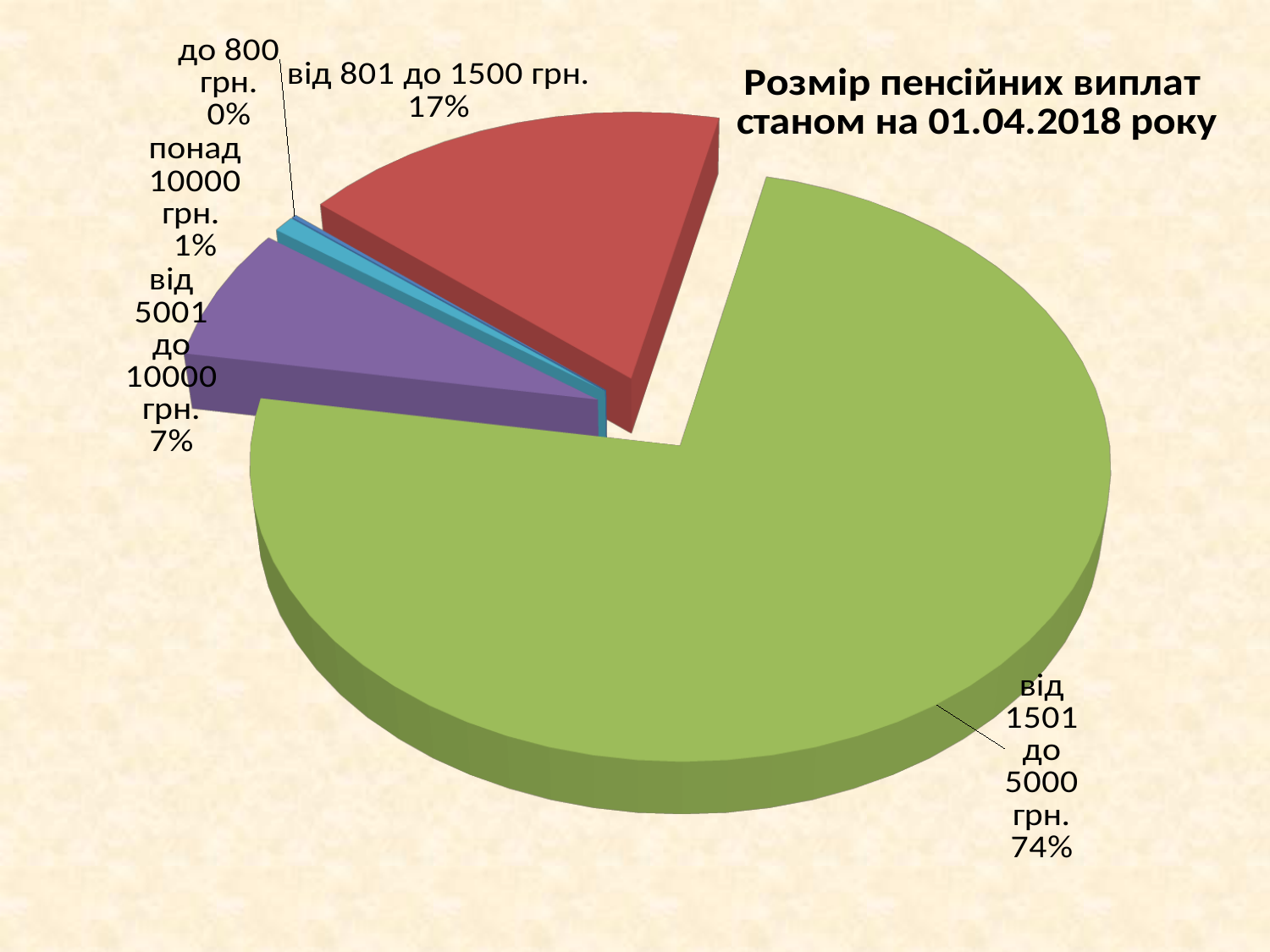
What share of the pie is the slice for "понад 10000 грн."? 1% What share of the pie is the slice for "до 800 грн."? 0% What is the title of the chart? Розмір пенсійних виплат станом на 01.04.2018 року Which category has the smallest share of the pie? до 800 грн. Which is larger: the share for "від 801 до 1500 грн." or the share for "від 5001 до 10000 грн."? від 801 до 1500 грн. What share of the pie is the slice for "від 5001 до 10000 грн."? 7% What type of chart is shown on the slide? pie chart What is the difference in percentage points between the shares for "від 801 до 1500 грн." and "від 5001 до 10000 грн."? 10% Which category has the largest share of the pie? від 1501 до 5000 грн. How many slices does the pie chart have? 5